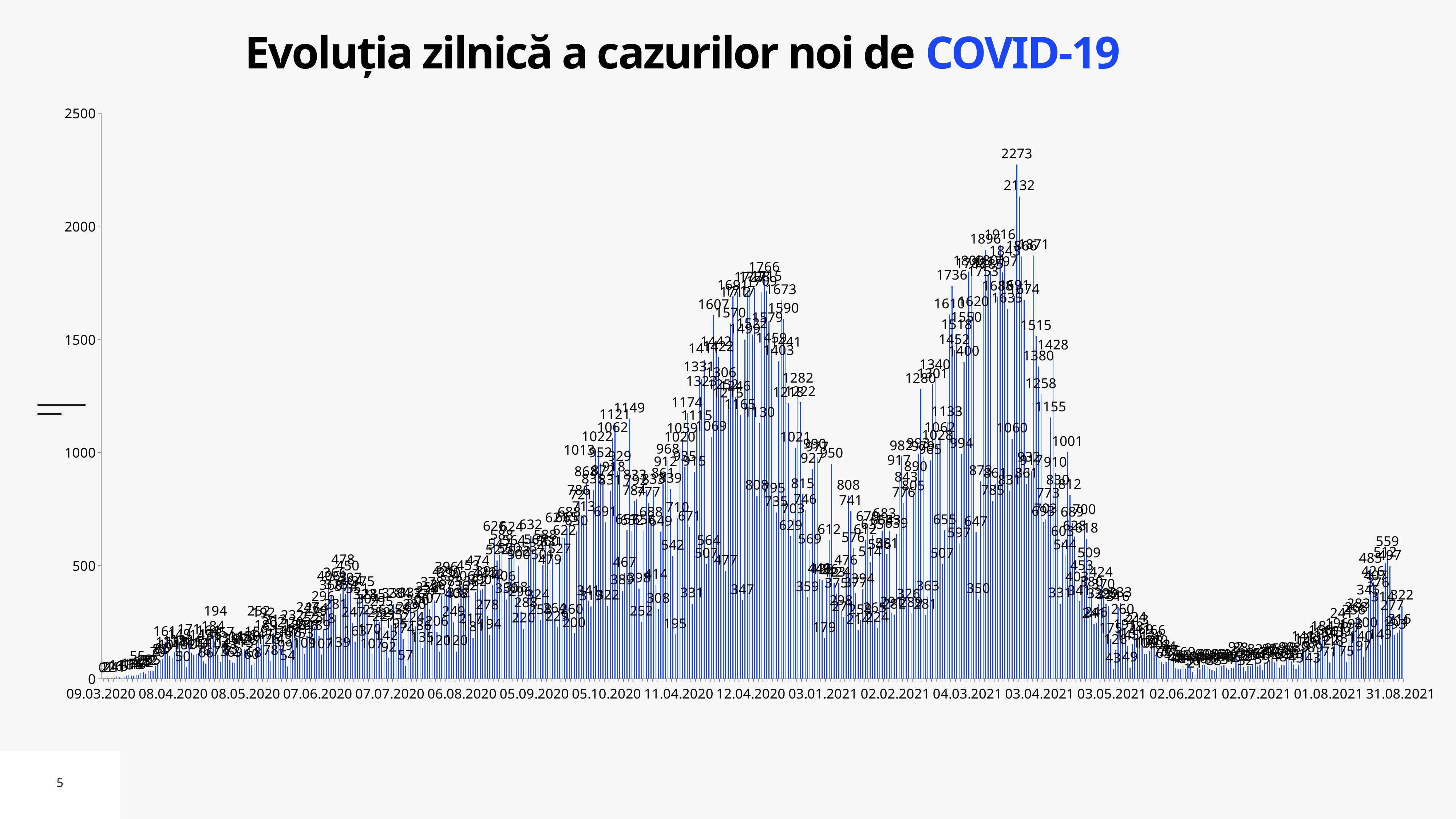
What is the last date label on the horizontal axis? 31.08.2021 What is the second-highest daily value labelled on the chart, just below the 2273 peak? 2132 What is the highest tick value shown on the vertical axis? 2500 Do the values rise or fall between the 03.04.2021 label and the 02.06.2021 label? fall Do the values rise or fall between the 02.07.2021 label and the 31.08.2021 label? rise Are the bars around the 02.06.2021 label greater or less than 500? less Is the highest bar on the chart greater or less than 2000? greater What is the first date label on the horizontal axis? 09.03.2020 What kind of chart is shown on the slide? bar chart What is the title of the chart? Evoluția zilnică a cazurilor noi de COVID-19 What is the difference between the two highest labelled values, 2273 and 2132? 141 What is the highest daily value labelled on the chart? 2273